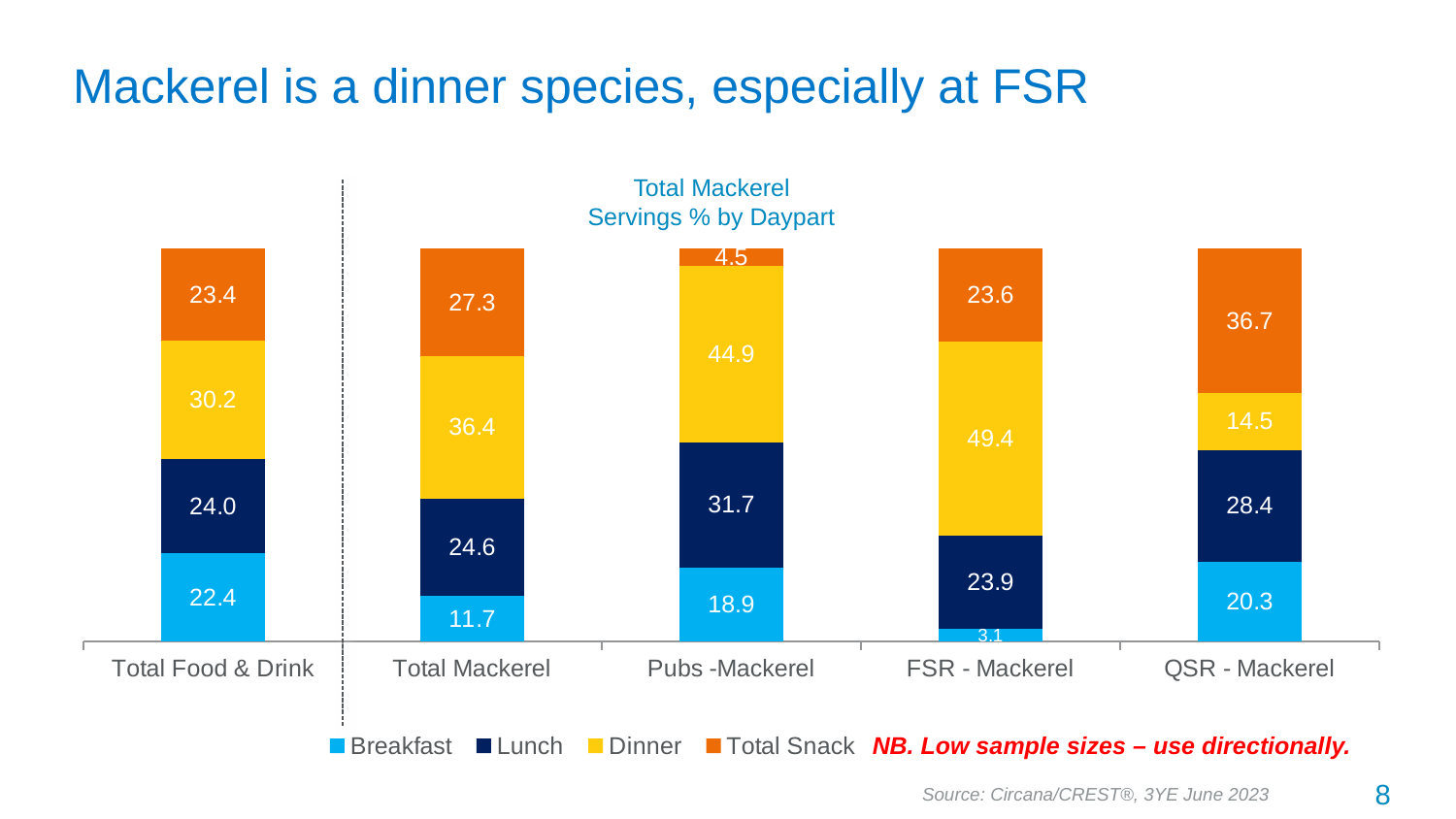
What is the Breakfast value for Total Mackerel? 11.7 What kind of chart is shown on the slide? Stacked bar chart What is the total of the stacked bar for Pubs -Mackerel? 100.0 What is the title of the chart? Total Mackerel Servings % by Daypart How many categories are shown on the x axis? 5 Which has the larger Total Snack value, QSR - Mackerel or Total Mackerel? QSR - Mackerel How many series does the legend list? 4 Which category has the highest Dinner value? FSR - Mackerel Which category has the lowest Breakfast value? FSR - Mackerel What is the Lunch value for Pubs -Mackerel? 31.7 What is the difference between the Dinner value for FSR - Mackerel and the Dinner value for QSR - Mackerel? 34.9 What is the Dinner value for FSR - Mackerel? 49.4